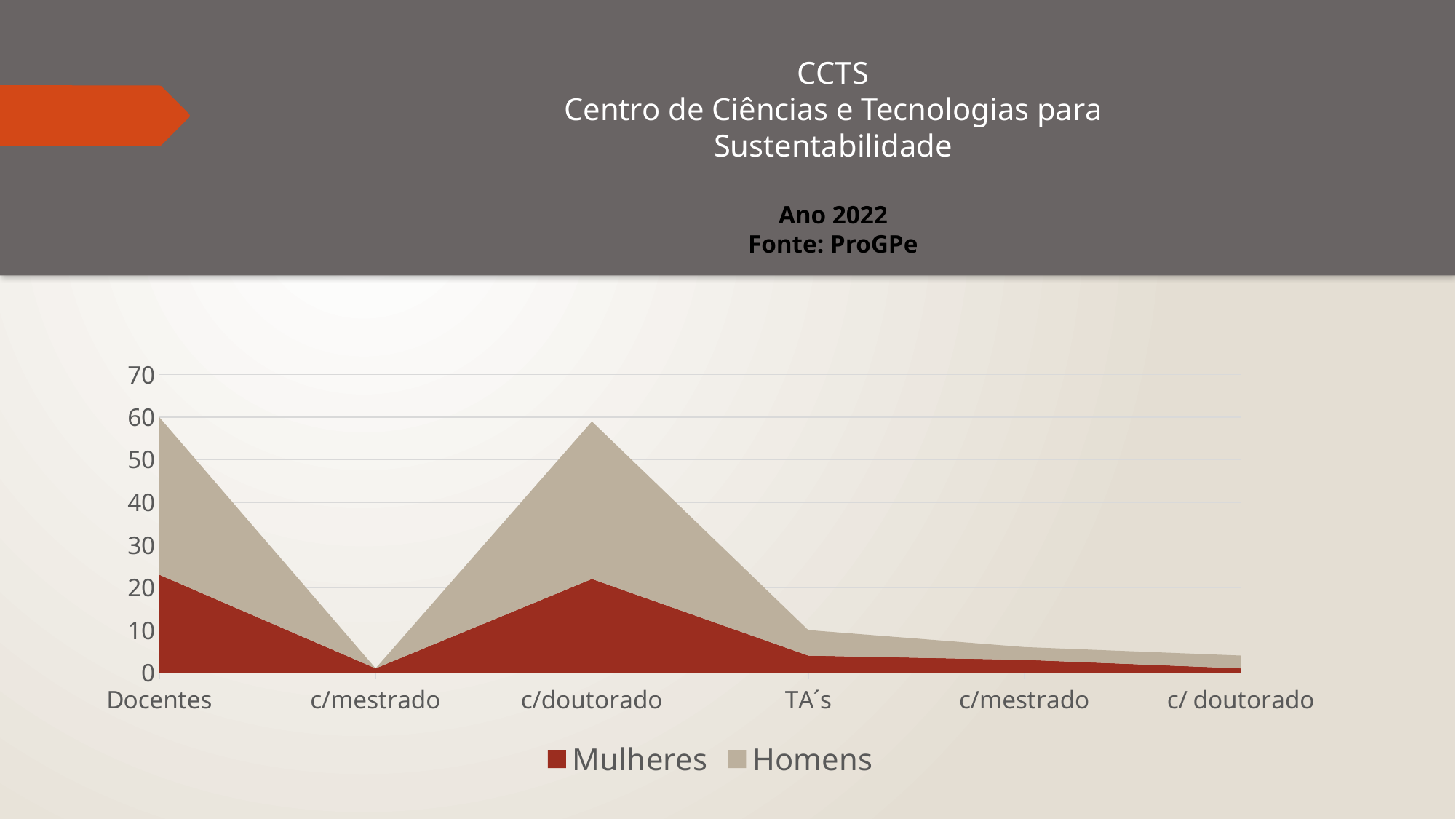
Is the value for Mulheres at Docentes greater or less than 30? less Which category has the lowest stacked total? c/mestrado (the first one, after Docentes) Do the stacked totals rise or fall from c/doutorado to TA´s? fall Which two series are listed in the legend? Mulheres and Homens How many categories are shown along the x axis? 6 Is the stacked total at Docentes greater or less than 50? greater Is the value for Mulheres at TA´s greater or less than 10? less How many series does the legend list? 2 What kind of chart is shown on the slide? area chart Which is larger, the Mulheres value at Docentes or the Mulheres value at TA´s? Docentes